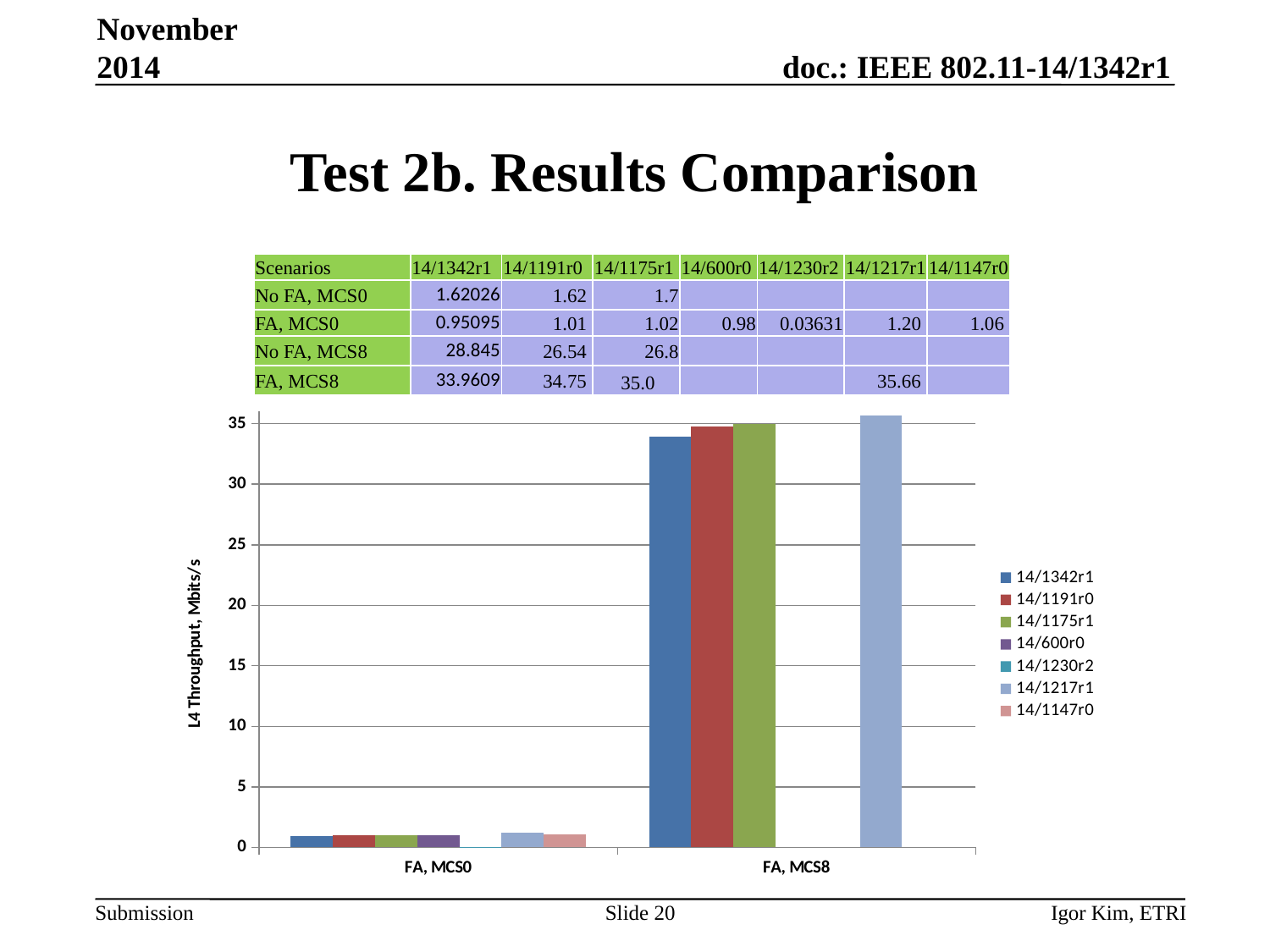
In the FA, MCS8 category, which is larger: 14/1191r0 or 14/1342r1? 14/1191r0 What is the label of the chart's y axis? L4 Throughput, Mbits/s What type of chart is shown on the slide? bar chart Which series has the highest value in the FA, MCS8 category? 14/1217r1 How many categories are shown on the x axis of the chart? 2 Which series has the highest value in the FA, MCS0 category? 14/1217r1 What is the value for 14/600r0 in the FA, MCS0 scenario? 0.98 Which series is listed first in the chart legend? 14/1342r1 How many series does the chart legend list? 7 What is the value for 14/1217r1 in the FA, MCS8 scenario? 35.66 Is the value for 14/1342r1 in FA, MCS8 greater or less than 30? greater What is the difference between the 14/1217r1 and 14/1175r1 values in the FA, MCS8 scenario? 0.66